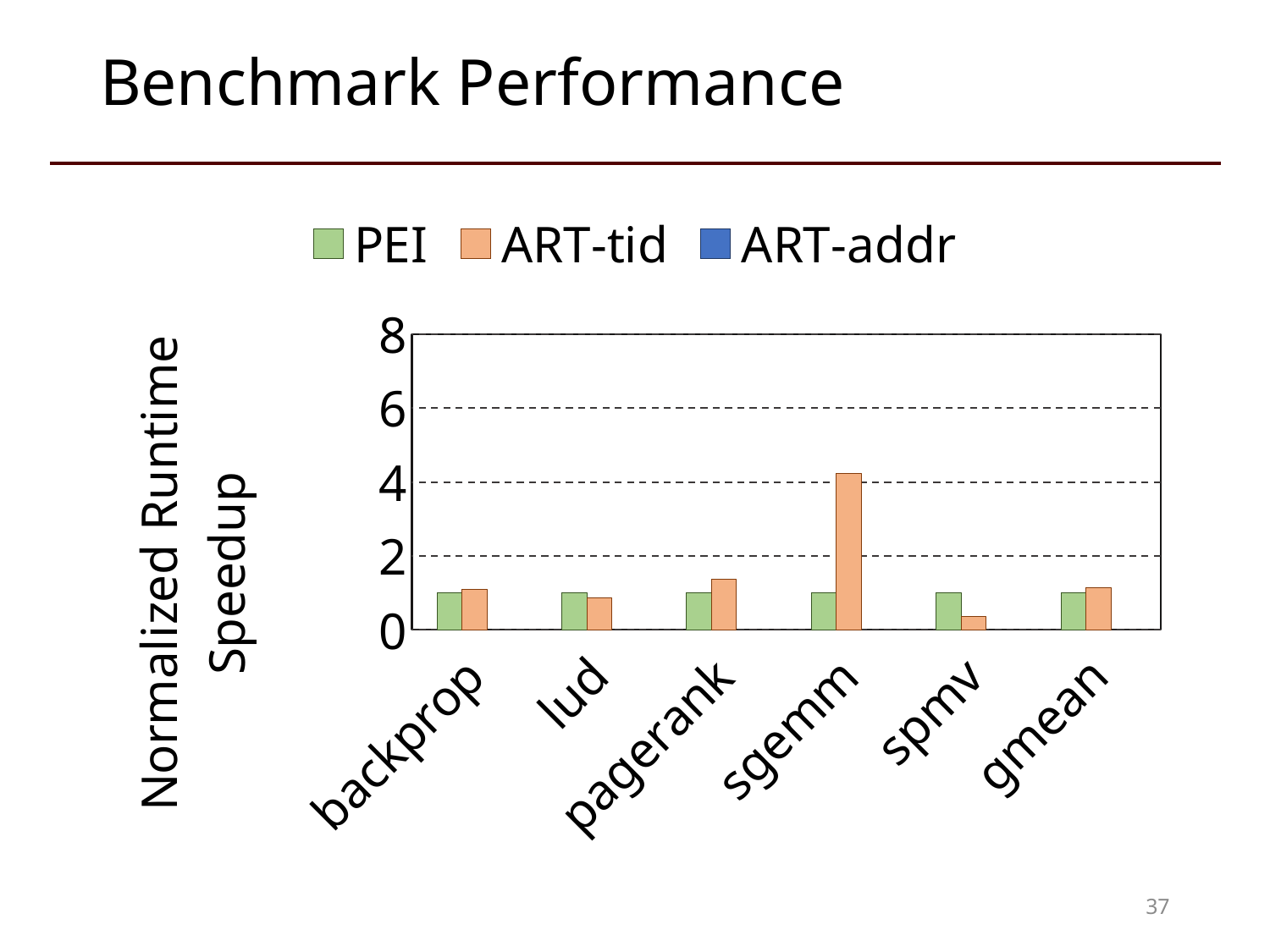
Is the ART-tid value for spmv greater or less than 2? less How many benchmark categories are shown on the x axis? 6 For spmv, which series has the larger value, PEI or ART-tid? PEI What kind of chart is shown on the slide? bar chart Which benchmark has the highest ART-tid speedup? sgemm How many series does the legend list? 3 What is the label on the y axis of the chart? Normalized Runtime Speedup For sgemm, which series has the larger value, PEI or ART-tid? ART-tid Which benchmark has the lowest ART-tid speedup? spmv Is the ART-tid value for sgemm greater or less than 2? greater Is the ART-tid value for sgemm greater or less than 6? less For pagerank, which series has the larger value, PEI or ART-tid? ART-tid